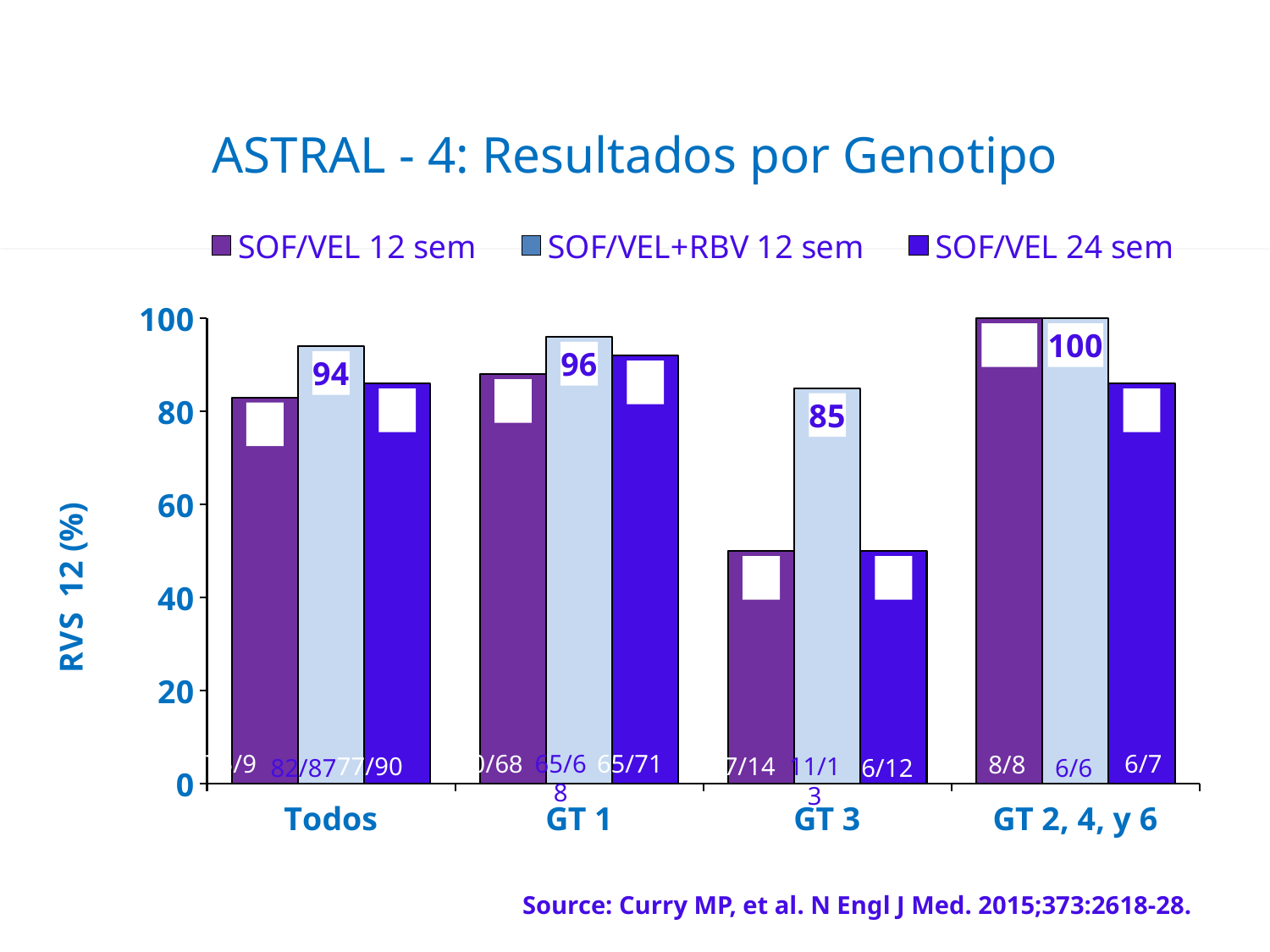
Is the value for SOF/VEL 12 sem in the GT 3 category greater or less than 60? less What is the value for SOF/VEL+RBV 12 sem in the GT 1 category? 96 How many categories are shown on the x axis? 4 Which category has the lowest value for SOF/VEL+RBV 12 sem? GT 3 What kind of chart is shown on the slide? bar chart What is the difference between the SOF/VEL+RBV 12 sem values for GT 1 and GT 3? 11 What is the value for SOF/VEL+RBV 12 sem in the Todos category? 94 Which category has the highest value for SOF/VEL+RBV 12 sem? GT 2, 4, y 6 How many series does the legend list? 3 In the GT 3 category, which is larger: SOF/VEL 12 sem or SOF/VEL+RBV 12 sem? SOF/VEL+RBV 12 sem What is the value for SOF/VEL+RBV 12 sem in the GT 3 category? 85 What is the value for SOF/VEL+RBV 12 sem in the GT 2, 4, y 6 category? 100